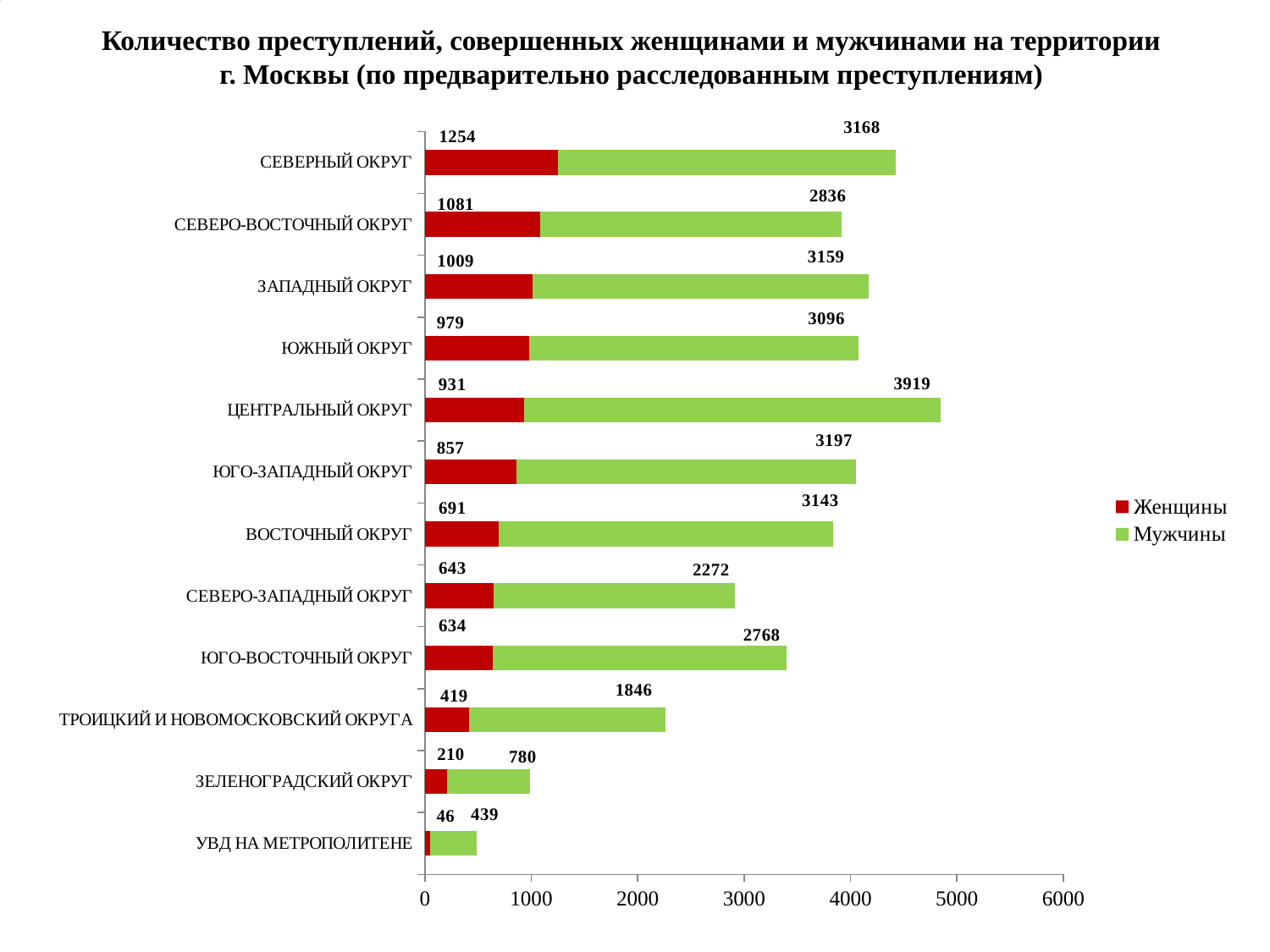
Which is larger, the Мужчины value for Восточный округ or for Северо-Западный округ? Восточный округ What is the value for Мужчины in Зеленоградский округ? 780 What is the value for Женщины in Северный округ? 1254 Which category has the highest value for Мужчины? Центральный округ Is the total of the stacked bar for Центральный округ greater or less than 4000? greater How many categories are shown on the chart? 12 What is the difference between the Мужчины values for Центральный округ and Северный округ? 751 What is the value for Мужчины in Центральный округ? 3919 Which category has the highest value for Женщины? Северный округ How many series does the legend list? 2 Which category has the lowest value for Мужчины? УВД на метрополитене What is the total of the stacked bar for Северный округ? 4422